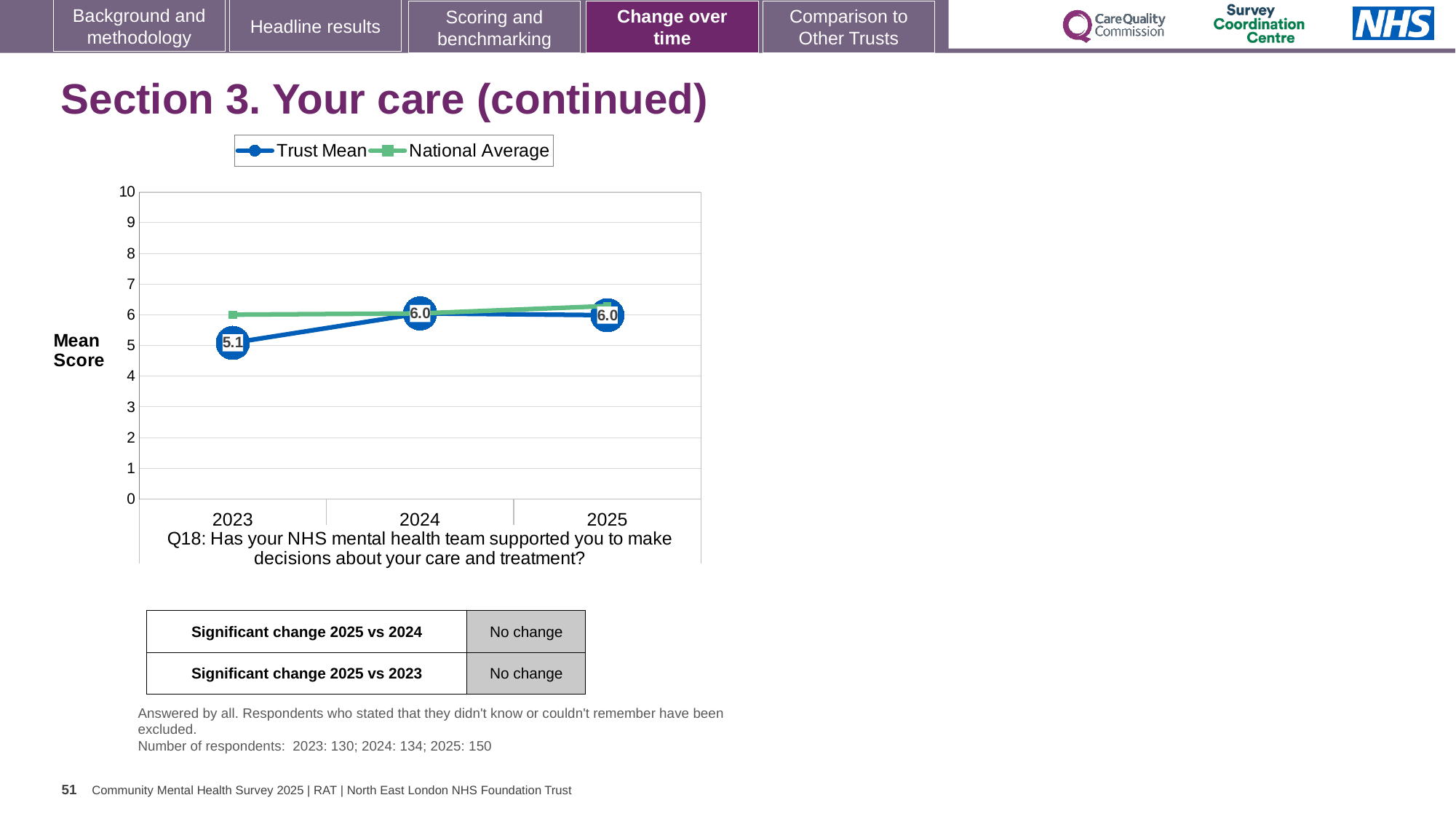
What is the difference between the Trust Mean in 2024 and in 2023? 0.9 What is the Trust Mean value for 2025? 6.0 In which year is the Trust Mean lowest? 2023 How many series does the legend list? 2 Is the National Average value for 2025 greater or less than 7? less What is the Trust Mean value for 2024? 6.0 What is the label on the y axis of the chart? Mean Score Is the National Average value for 2023 greater or less than 5? greater What is the Trust Mean value for 2023? 5.1 How many years are plotted on the x axis? 3 What kind of chart is shown on the slide? line chart Which is larger, the Trust Mean for 2023 or for 2024? 2024